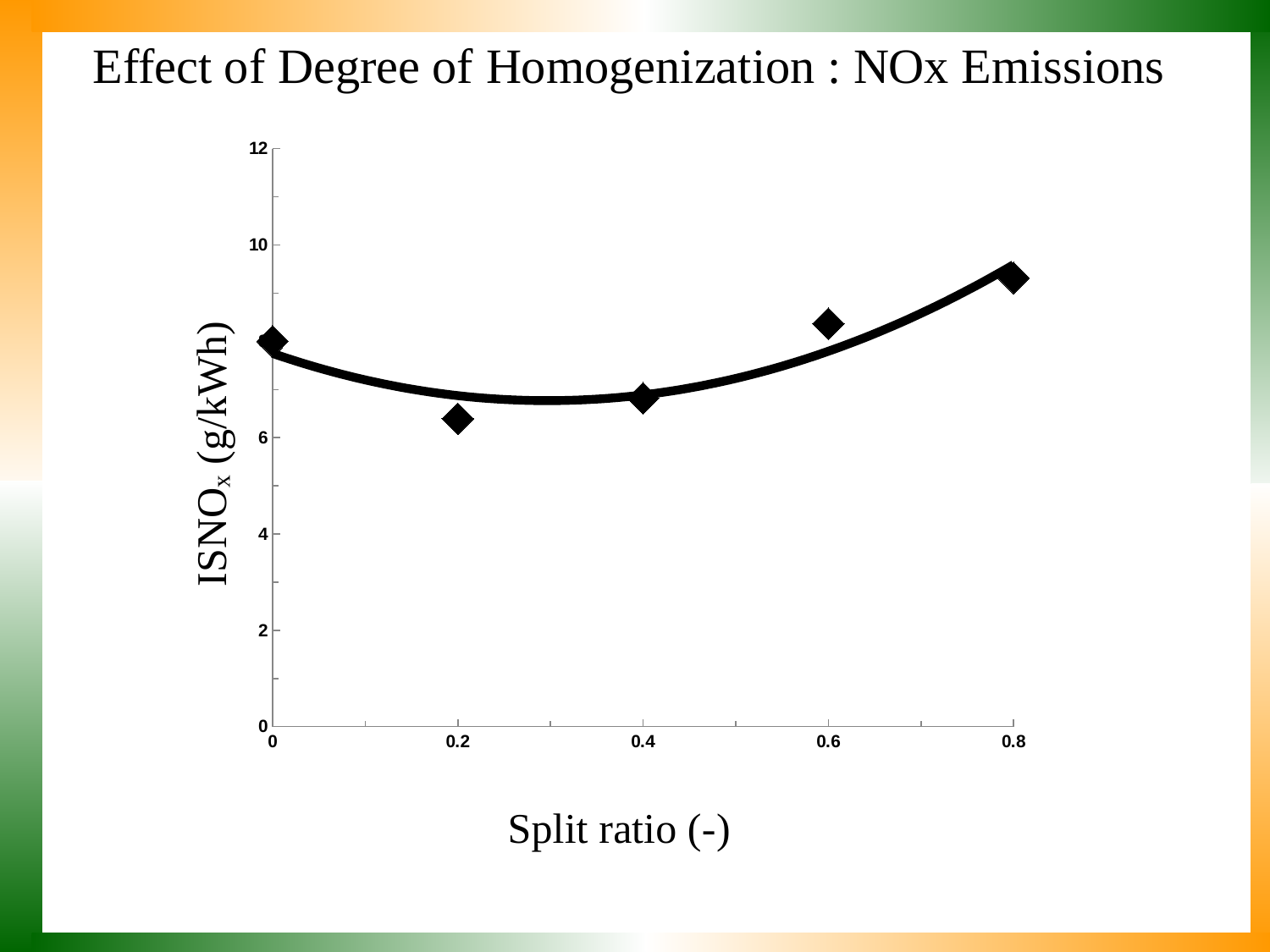
At which split ratio is the ISNOx value lowest? 0.2 Is the ISNOx value at split ratio 0.2 greater or less than 6? greater What is the label of the y axis? ISNOx (g/kWh) Is the ISNOx value at split ratio 0.8 greater or less than 10? less At which split ratio is the ISNOx value highest? 0.8 What kind of chart is shown on the slide? Scatter plot with a trend line What is the label of the x axis? Split ratio (-) How many data points are plotted on the chart? 5 How does the ISNOx value change as the split ratio increases from 0 to 0.8? It falls first, then rises Is the ISNOx value at split ratio 0 greater or less than 10? less Which has the larger ISNOx value: split ratio 0 or split ratio 0.2? 0 Which has the larger ISNOx value: split ratio 0.8 or split ratio 0.2? 0.8